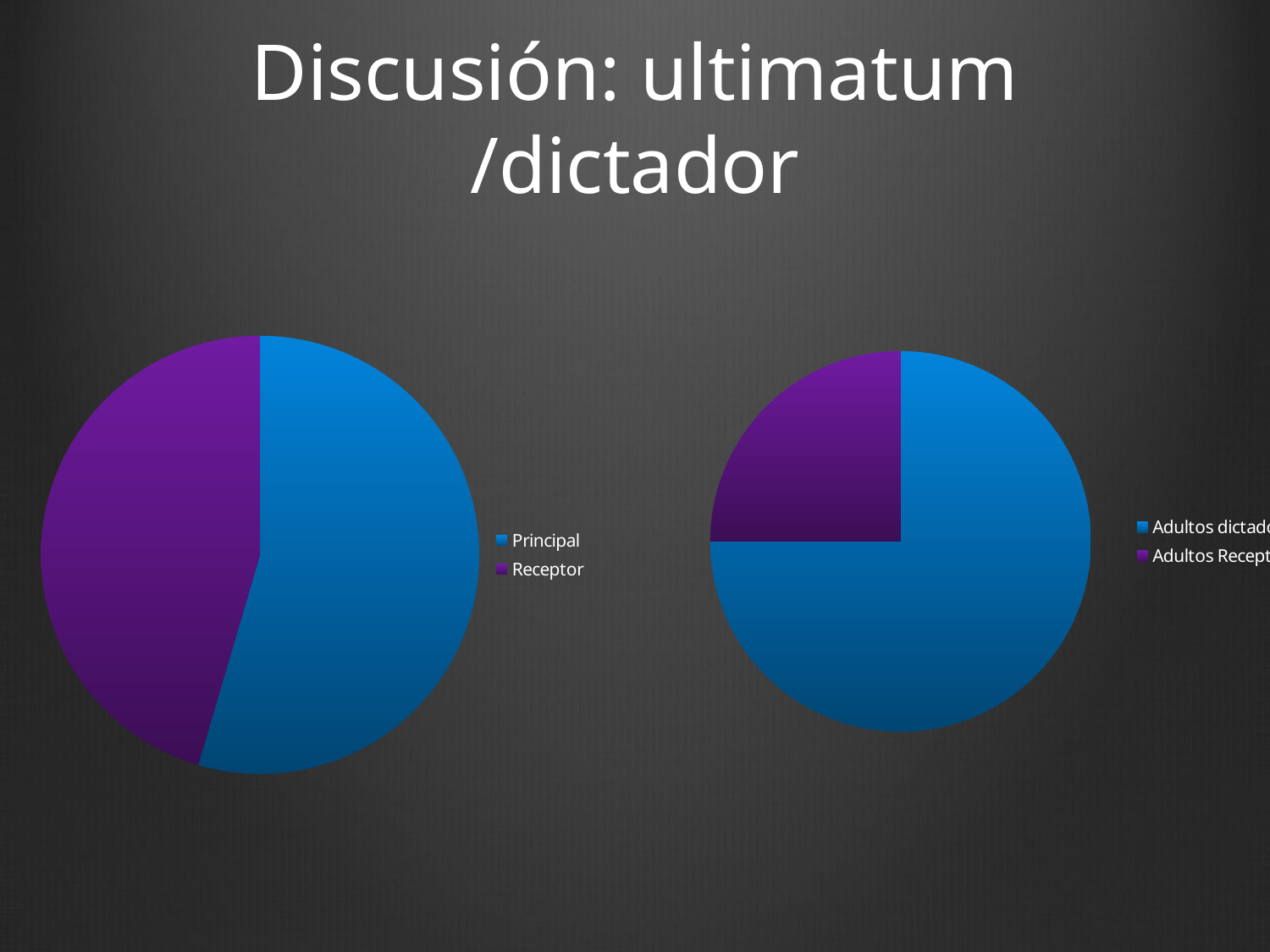
In the left pie chart, how many entries does the legend list? 2 In the left pie chart, what colour is the Principal slice? blue In the left pie chart, which category has the largest slice? Principal In the left pie chart, which category has the smallest slice? Receptor In the left pie chart, how many slices are there? 2 How many charts are shown on the slide? 2 What kind of chart is the left chart on the slide? pie chart What kind of chart is the right chart on the slide? pie chart In the left pie chart, what are the two legend entries? Principal, Receptor In the right pie chart, which slice is larger, the blue slice or the purple slice? the blue slice In the right pie chart, how many slices are there? 2 In the left pie chart, which slice is larger, Principal or Receptor? Principal